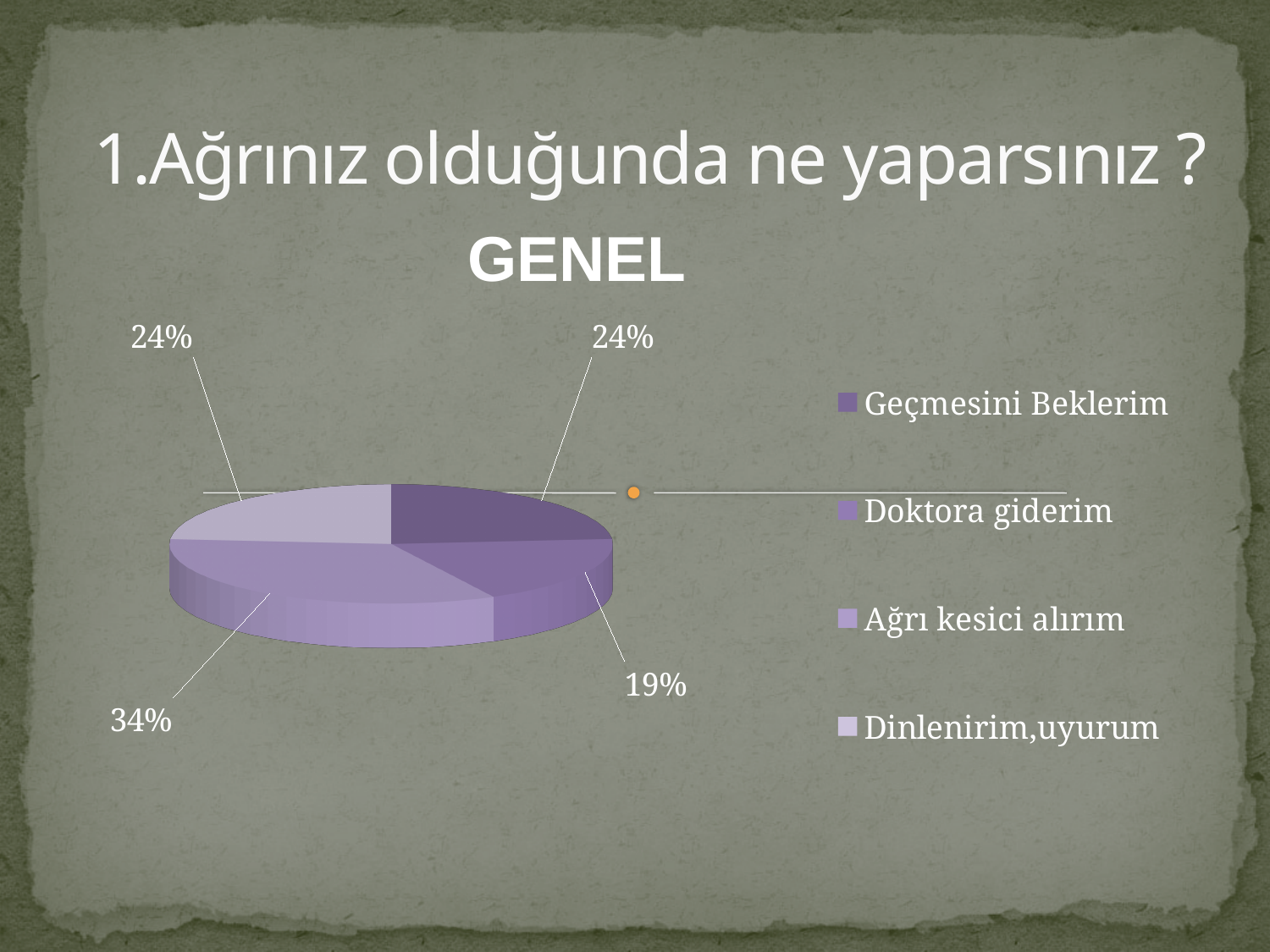
Which response has the smallest share of the pie? Doktora giderim How many slices does the pie chart have? 4 What percentage of respondents answered "Dinlenirim,uyurum"? 24% What is the difference in percentage points between "Ağrı kesici alırım" and "Doktora giderim"? 15 Which is larger, the share for "Ağrı kesici alırım" or the share for "Geçmesini Beklerim"? Ağrı kesici alırım Which response has the largest share of the pie? Ağrı kesici alırım What percentage of respondents answered "Geçmesini Beklerim"? 24% How many entries does the legend list? 4 What is the title of the chart? GENEL What percentage of respondents answered "Ağrı kesici alırım"? 34% What kind of chart is shown on the slide? Pie chart What percentage of respondents answered "Doktora giderim"? 19%